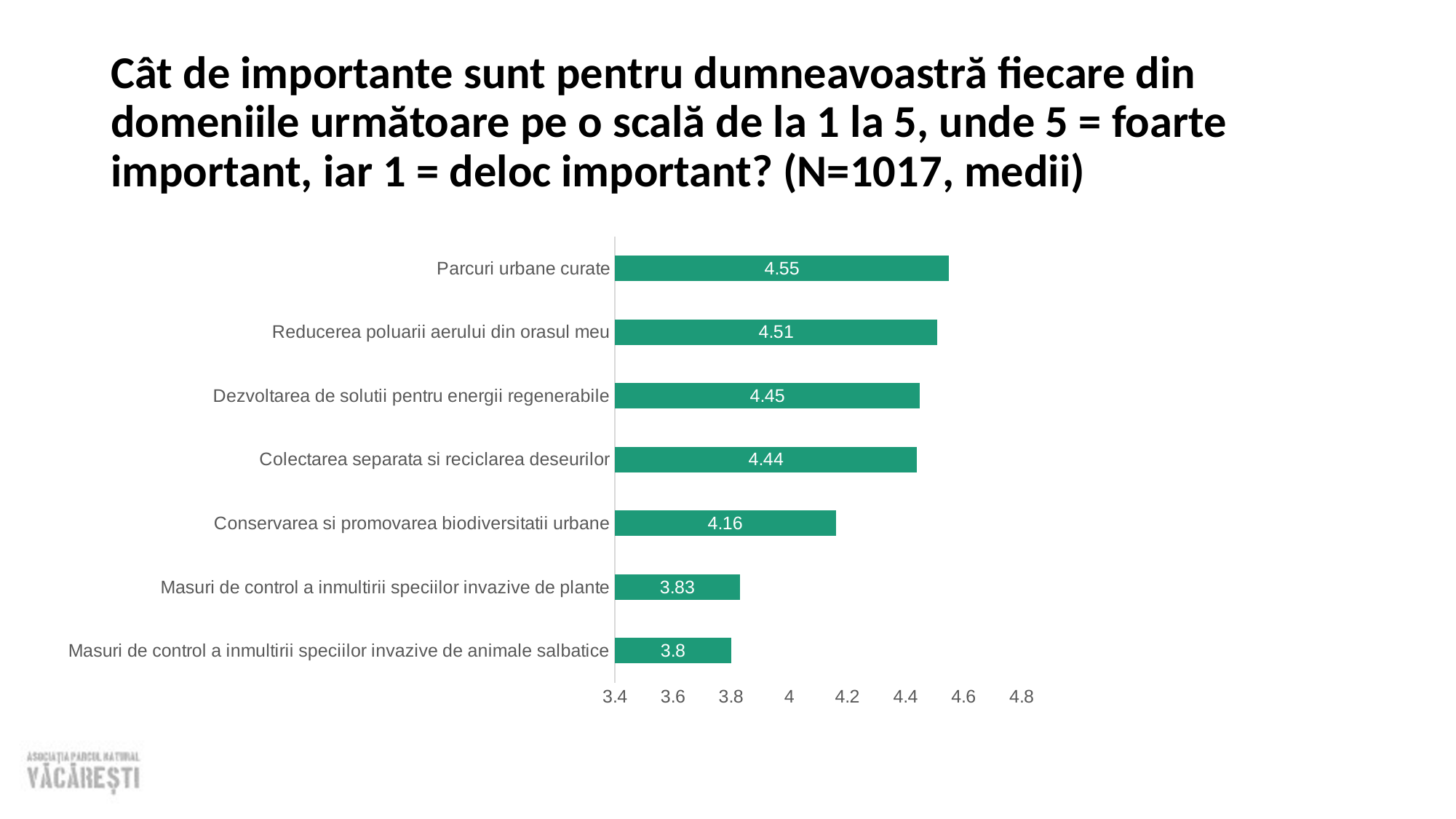
Which category has the highest value? Parcuri urbane curate What is the value for "Conservarea si promovarea biodiversitatii urbane"? 4.16 Is the value for "Colectarea separata si reciclarea deseurilor" greater or less than 4.2? greater What is the difference between the values for "Reducerea poluarii aerului din orasul meu" and "Masuri de control a inmultirii speciilor invazive de plante"? 0.68 Which category has the lowest value? Masuri de control a inmultirii speciilor invazive de animale salbatice What kind of chart is shown on the slide? Bar chart How many categories are shown in the chart? 7 What is the difference between the values for "Parcuri urbane curate" and "Conservarea si promovarea biodiversitatii urbane"? 0.39 What is the value for "Masuri de control a inmultirii speciilor invazive de animale salbatice"? 3.8 Which has a larger value: "Dezvoltarea de solutii pentru energii regenerabile" or "Conservarea si promovarea biodiversitatii urbane"? Dezvoltarea de solutii pentru energii regenerabile What is the value for "Parcuri urbane curate"? 4.55 What is the sample size (N) stated in the chart title? 1017